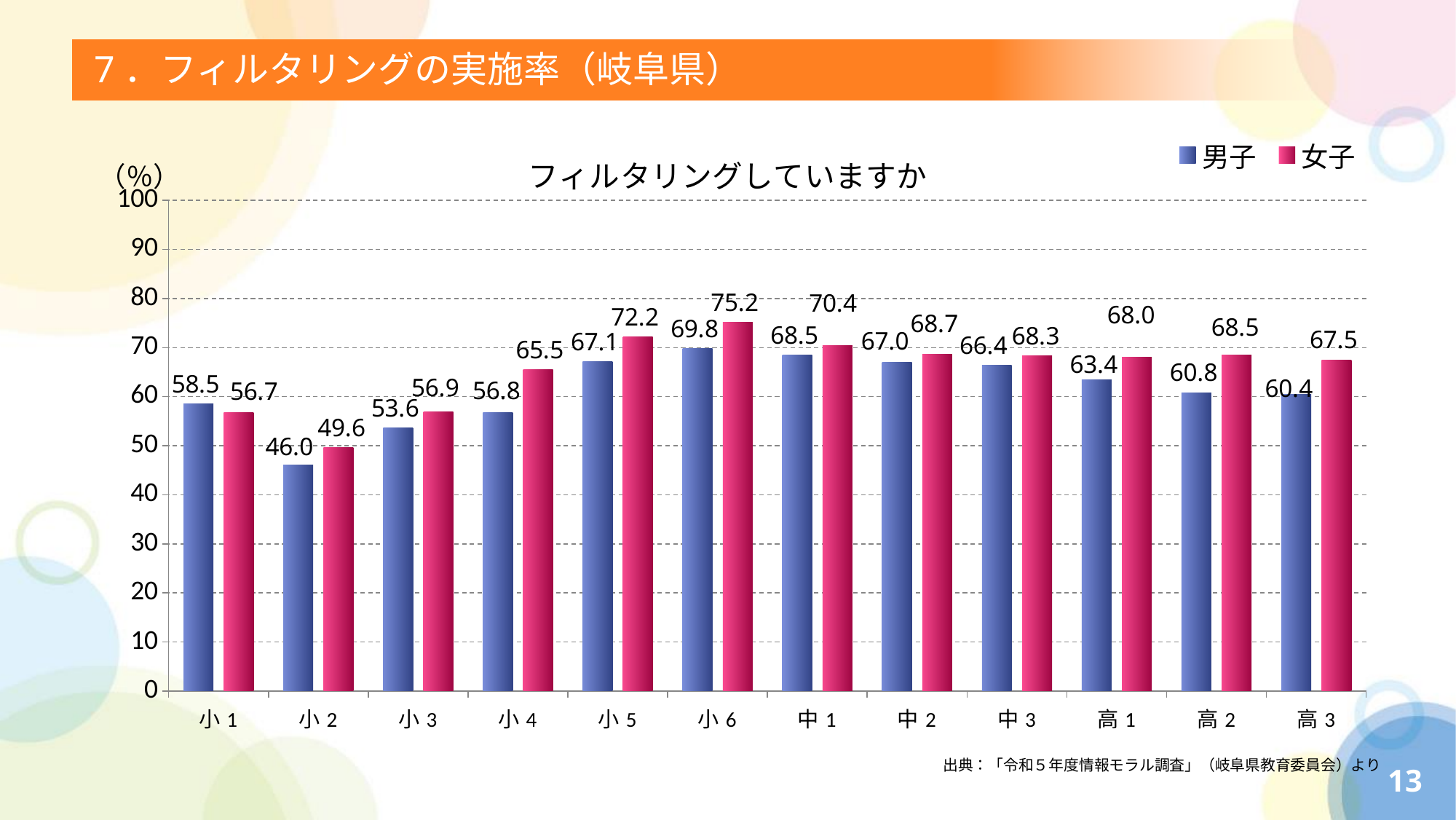
Is the value for 女子 at 小2 greater or less than 60? less How many series does the legend list? 2 What is the value for 男子 at 小6? 69.8 Which category has the highest value for 女子? 小6 Which is larger at 小1, the value for 男子 or the value for 女子? 男子 How many categories are shown on the x axis? 12 What is the value for 女子 at 高2? 68.5 What kind of chart is shown on the slide? bar chart What is the difference between the 女子 and 男子 values at 小4? 8.7 Which category has the lowest value for 男子? 小2 What is the value for 男子 at 小2? 46.0 What is the title of the chart? フィルタリングしていますか